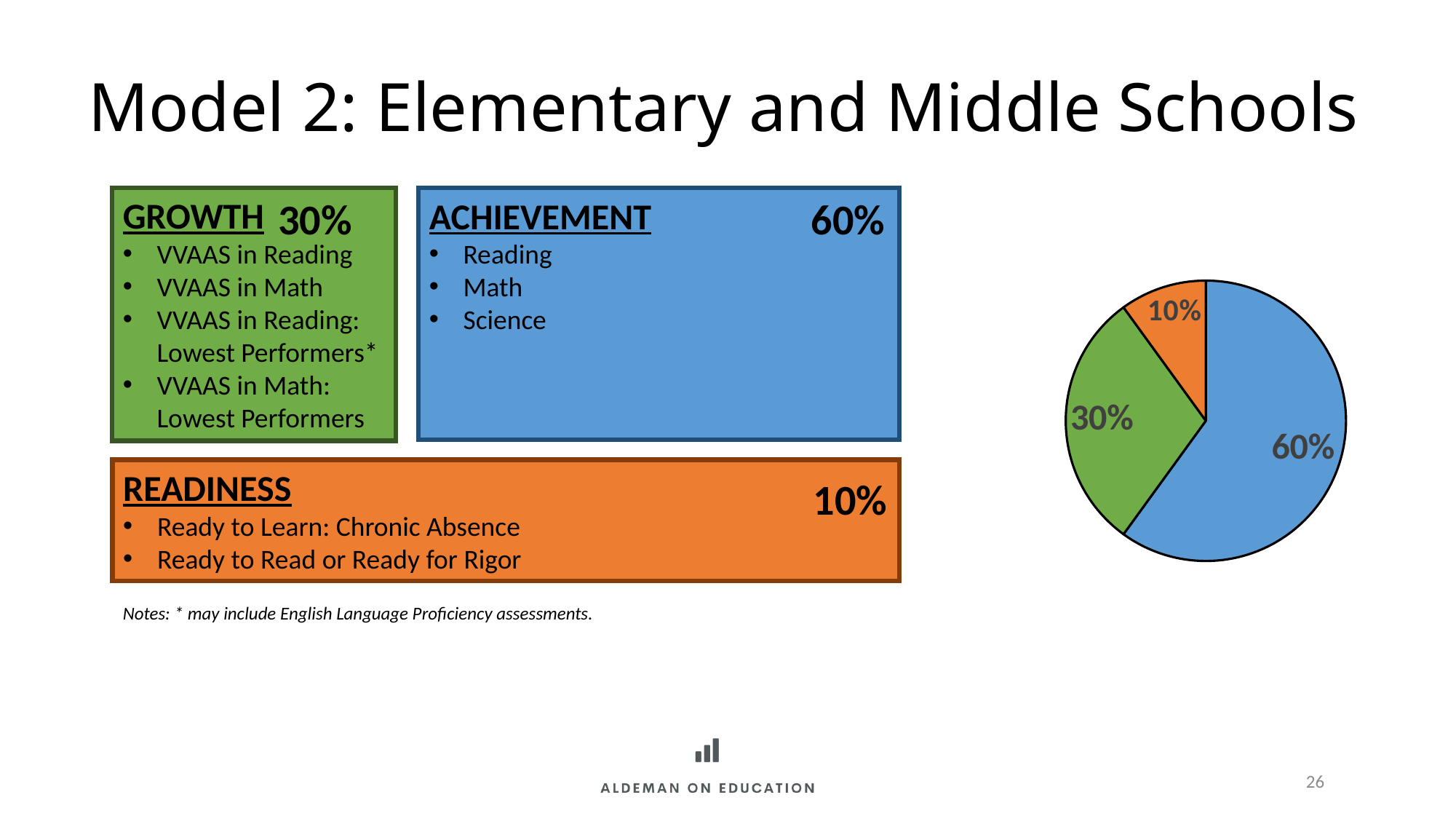
What is the difference between the blue slice and the green slice in the pie chart? 30% Which slice of the pie chart is the largest? the blue slice (60%) What share of the pie chart does the blue slice represent? 60% How many slices does the pie chart have? 3 What percentage is shown on the blue slice of the pie chart? 60% Which is larger in the pie chart, the green slice or the orange slice? the green slice What percentage is shown on the green slice of the pie chart? 30% What is the combined share of the green and orange slices in the pie chart? 40% What percentage is shown on the orange slice of the pie chart? 10% Which slice of the pie chart is the smallest? the orange slice (10%) What kind of chart is shown on the right side of the slide? pie chart Which colour in the pie chart corresponds to the Achievement component, based on the matching box on the slide? blue